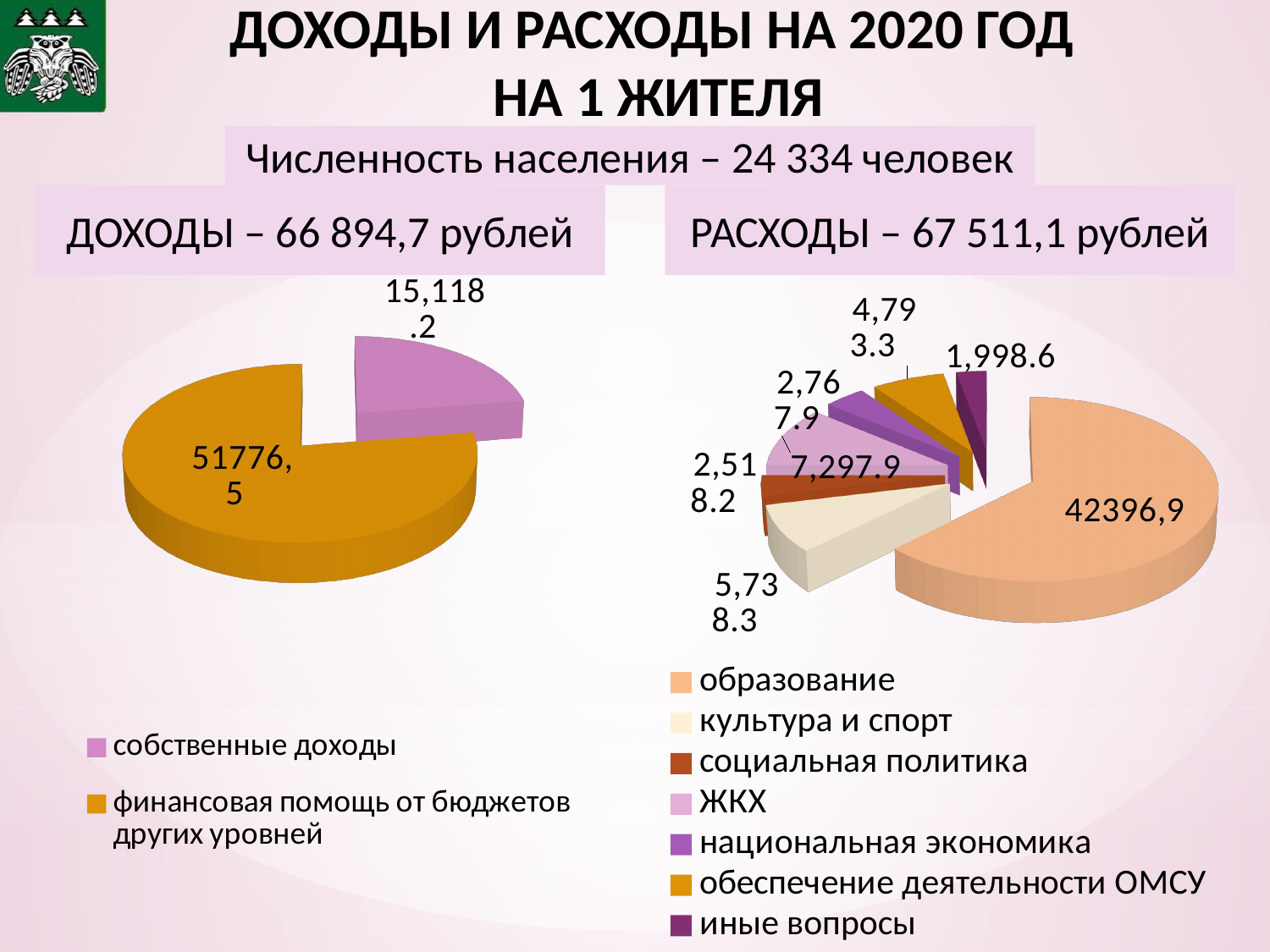
In the РАСХОДЫ chart on the right, what is the difference between ЖКХ and культура и спорт? 1,559.6 In the ДОХОДЫ chart on the left, which category has the larger slice? финансовая помощь от бюджетов других уровней In the ДОХОДЫ chart on the left, what is the value for собственные доходы? 15,118.2 In the РАСХОДЫ chart on the right, what is the value for ЖКХ? 7,297.9 In the ДОХОДЫ chart on the left, what is the value for финансовая помощь от бюджетов других уровней? 51776,5 In the РАСХОДЫ chart on the right, what is the value for обеспечение деятельности ОМСУ? 4,793.3 How many slices does the РАСХОДЫ chart on the right have? 7 In the РАСХОДЫ chart on the right, what is the value for образование? 42396,9 In the РАСХОДЫ chart on the right, which is larger: ЖКХ or культура и спорт? ЖКХ In the РАСХОДЫ chart on the right, which category has the smallest slice? иные вопросы How many entries does the legend of the ДОХОДЫ chart on the left list? 2 What kind of chart is the ДОХОДЫ chart on the left? pie chart